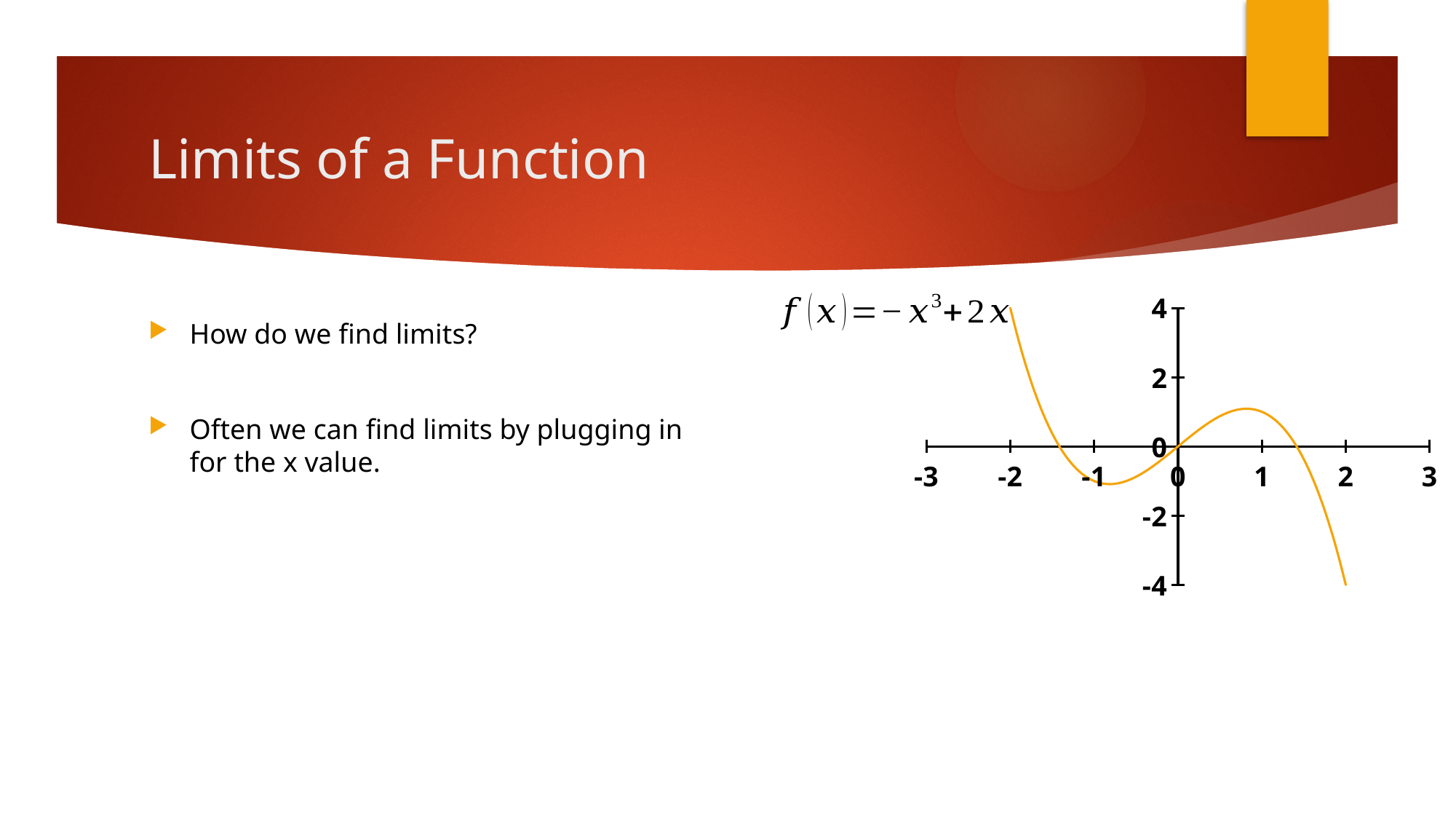
Does the curve rise or fall as x goes from -1 to 1? rise What is the value of the curve at x = 0? 0 Is the value of the curve at x = -1 greater or less than 0? less Is the value of the curve at x = 1 greater or less than 0? greater Which is larger, the value of the curve at x = -2 or at x = 2? x = -2 Does the curve rise or fall as x goes from 1 to 2? fall What is the value of the curve at x = -2? 4 What function is plotted on the chart? f(x) = -x^3 + 2x What is the difference between the value of the curve at x = -2 and at x = 2? 8 What kind of chart is shown on the slide? line chart What colour is the plotted curve? orange What is the value of the curve at x = 2? -4